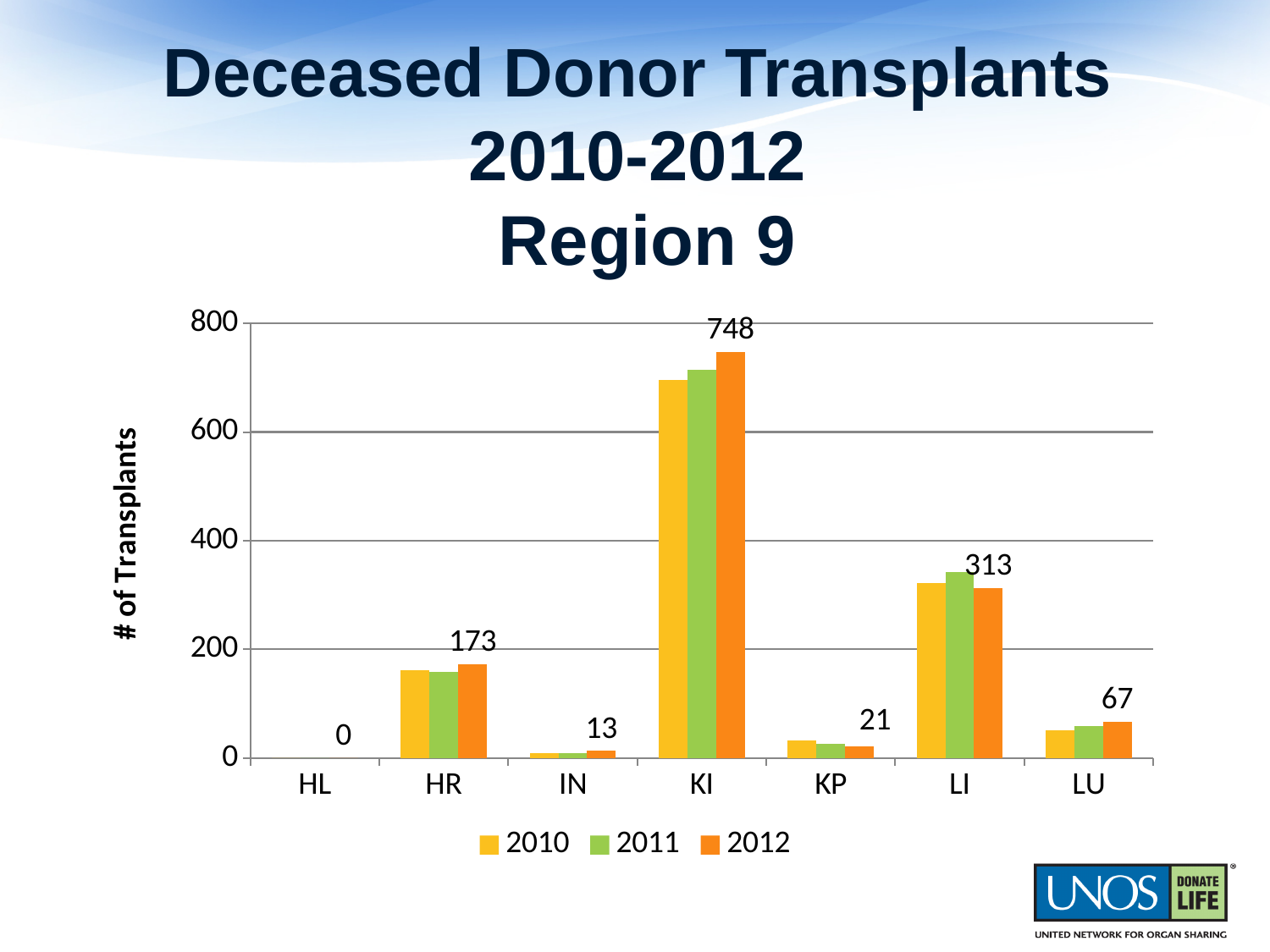
What is the 2012 value for LI? 313 What kind of chart is shown on the slide? Bar chart What is the 2012 value for HR? 173 Which is larger, the 2012 value for IN or the 2012 value for KP? KP How many series does the legend list? 3 What is the 2012 value for LU? 67 What is the 2012 value for HL? 0 Is the 2010 value for KI greater or less than 600? greater What is the difference between the 2012 values for KI and LI? 435 Which organ category has the highest number of transplants in 2012? KI What is the 2012 value for KI? 748 How many organ categories are shown on the x axis? 7